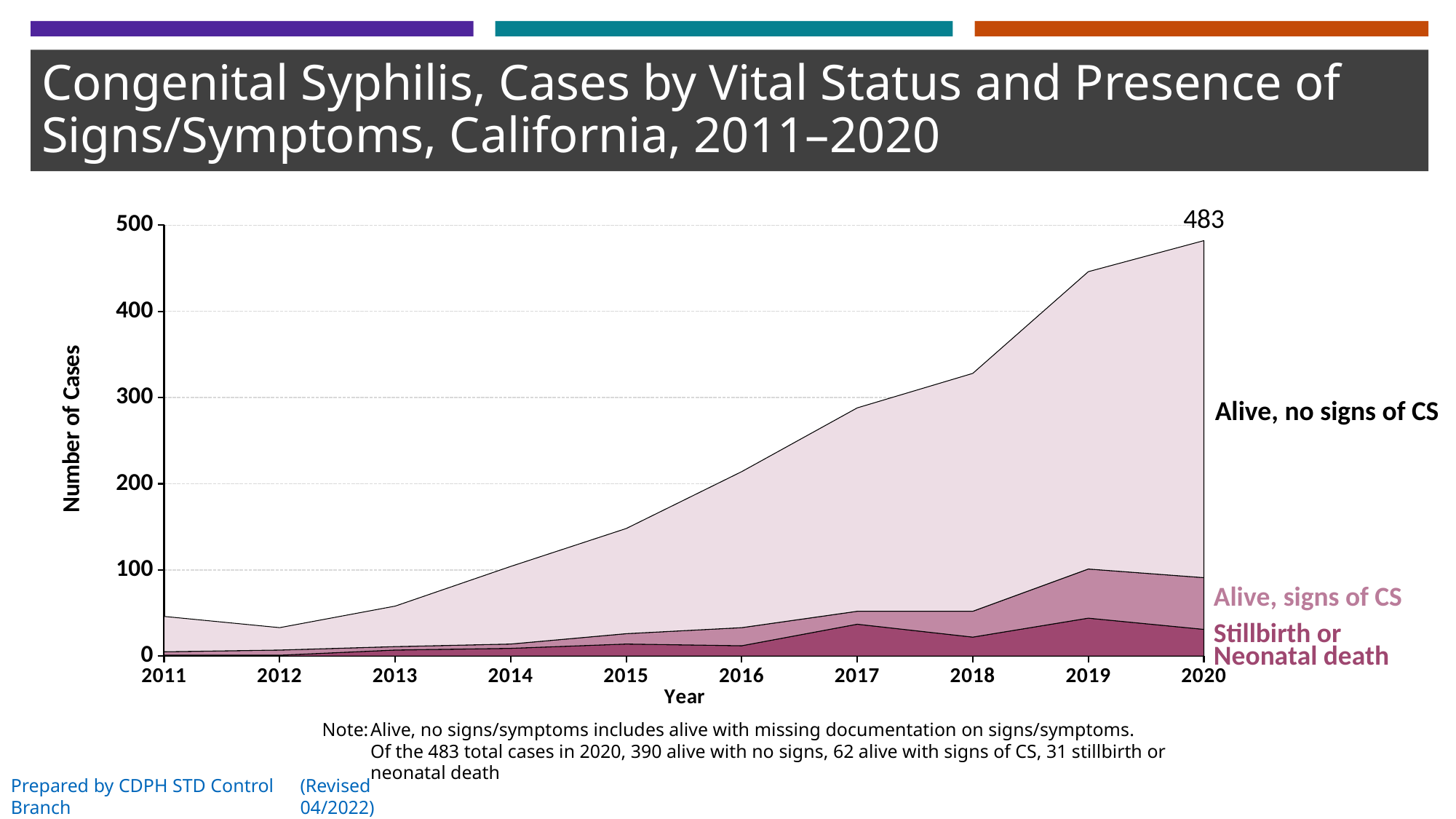
How many of the 2020 cases were alive with no signs of CS? 390 In 2020, how many more cases were alive with no signs of CS than alive with signs of CS? 328 Which year has the lowest total number of cases? 2012 Which year has the highest total number of cases? 2020 How many of the 2020 cases were stillbirth or neonatal death? 31 How many series (categories) does the chart show? 3 How many years are plotted along the x axis? 10 What was the total number of congenital syphilis cases in 2020? 483 How many of the 2020 cases were alive with signs of CS? 62 Do total cases generally rise or fall from 2011 to 2020? rise What kind of chart is shown on the slide? Stacked area chart Is the total number of cases in 2019 greater or less than 400? greater